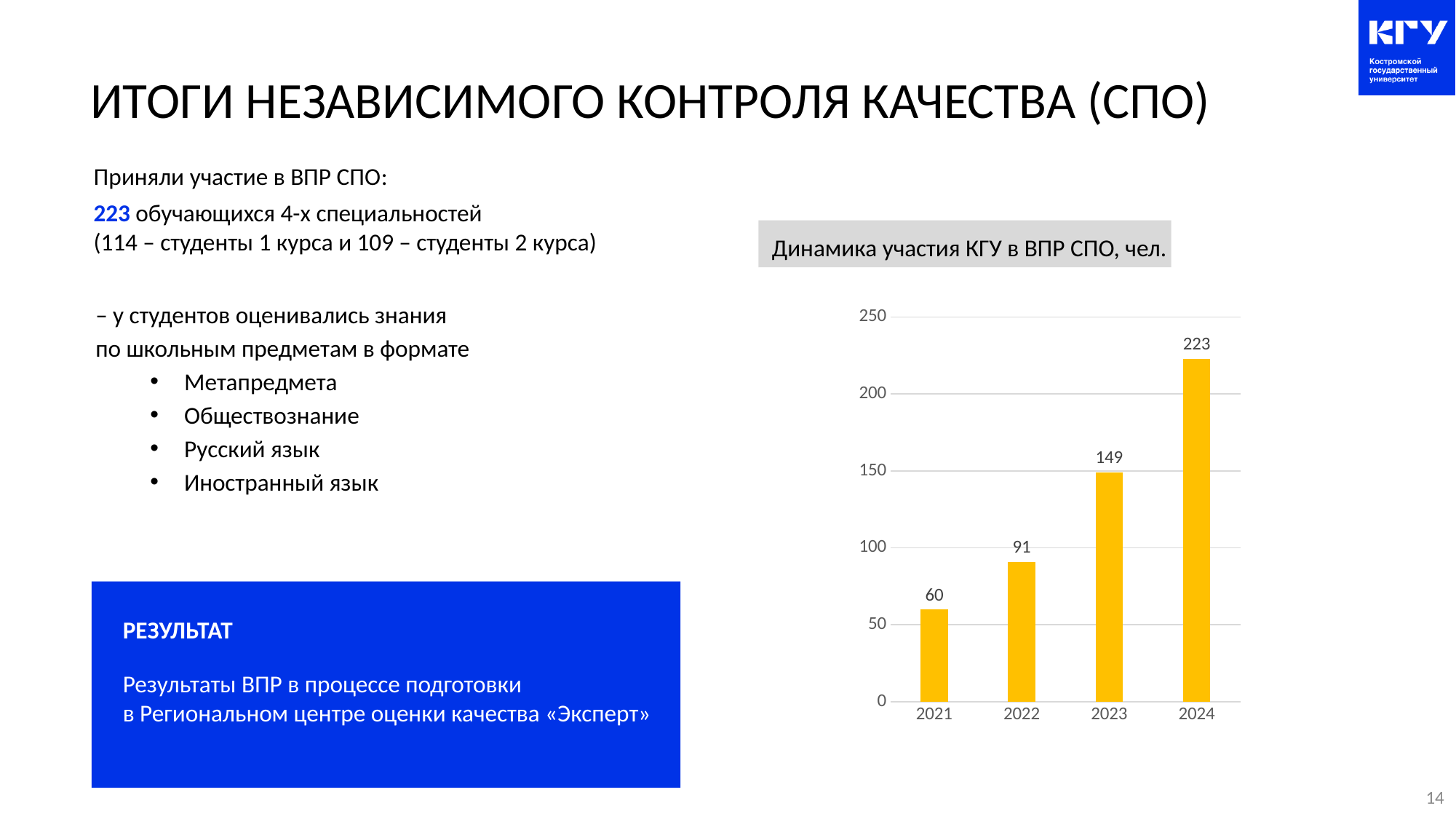
Which is larger, the value for 2022 or the value for 2023? 2023 Which year has the highest value in the chart? 2024 What is the value for 2022 in the chart? 91 What is the value for 2021 in the chart? 60 What is the value for 2024 in the chart? 223 Do the values rise or fall from 2021 to 2024? rise What is the difference between the values for 2024 and 2023? 74 What is the difference between the values for 2022 and 2021? 31 How many years are shown on the x axis of the chart? 4 What is the value for 2023 in the chart? 149 Which year has the lowest value in the chart? 2021 What kind of chart is shown on the slide? bar chart